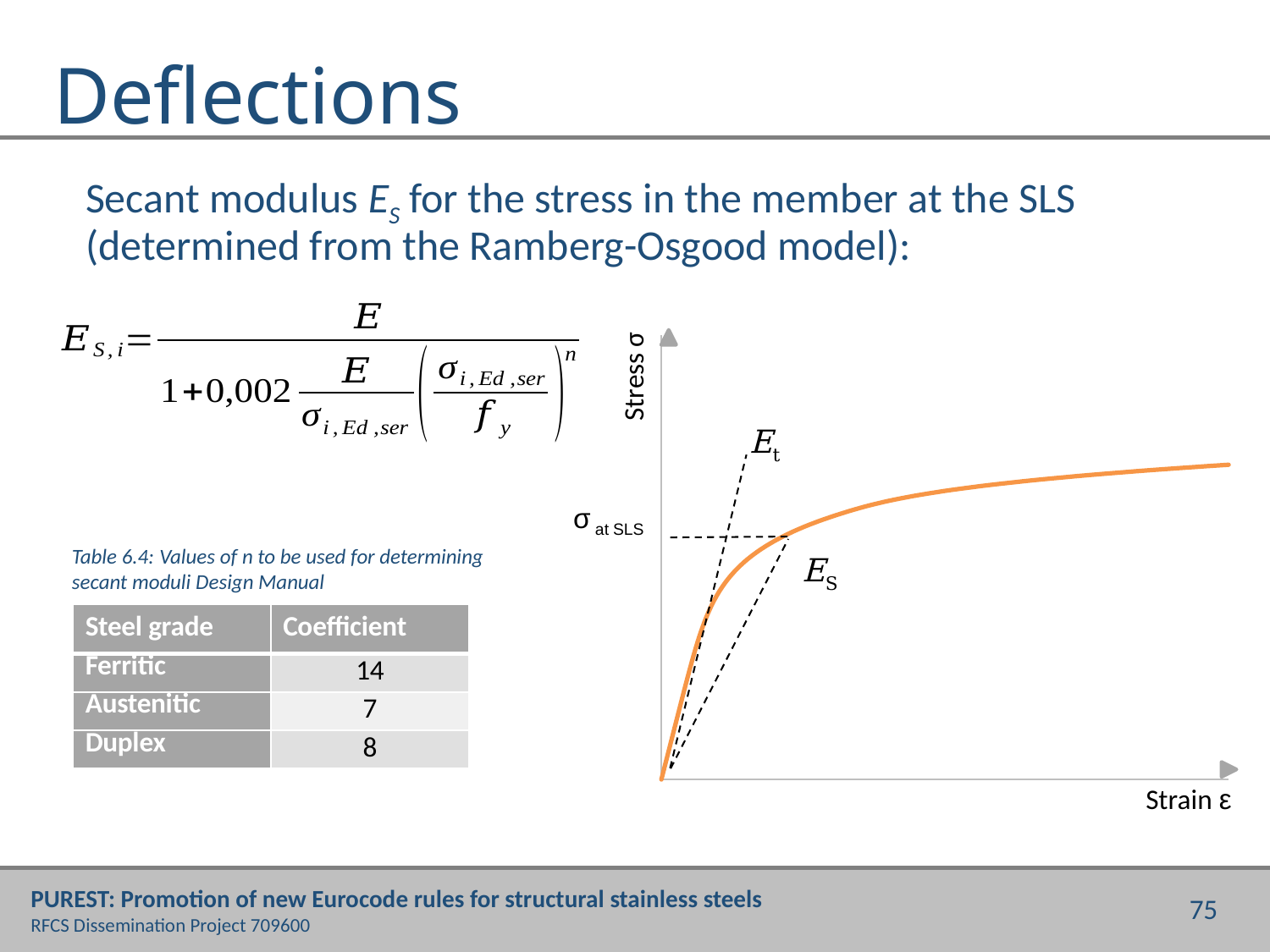
What is the label of the horizontal axis of the stress-strain chart? Strain ε How many solid curves are plotted in the stress-strain chart? 1 What kind of chart is shown on the right of the slide? line chart In the stress-strain chart, which dashed modulus line is steeper, Et or Es? Et In the stress-strain chart, does stress rise or fall as strain increases along the x axis? rises What stress level is marked by the horizontal dashed line in the stress-strain chart? σ at SLS